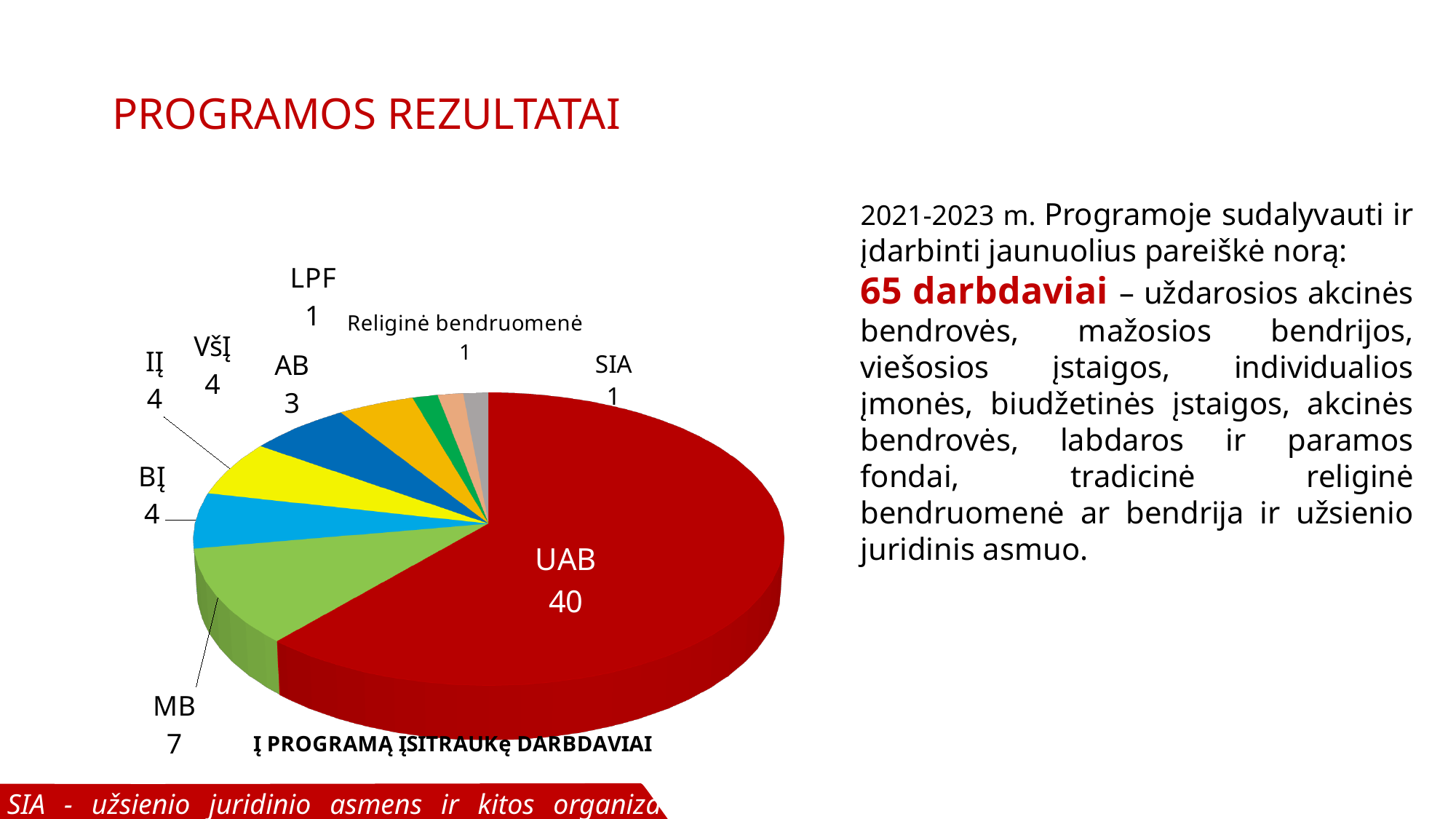
What kind of chart is shown on the slide? Pie chart What is the value for Religinė bendruomenė in the pie chart? 1 Which is larger, the value for MB or the value for AB? MB What is the value for AB in the pie chart? 3 What is the difference between the values for UAB and MB? 33 What is the value for UAB in the pie chart? 40 What is the value for MB in the pie chart? 7 Which categories share the smallest value in the pie chart? LPF, Religinė bendruomenė, SIA Which category has the largest slice in the pie chart? UAB What is the title of the pie chart? Į PROGRAMĄ ĮSITRAUKę DARBDAVIAI How many categories (slices) does the pie chart have? 9 What is the total of all the values in the pie chart? 65